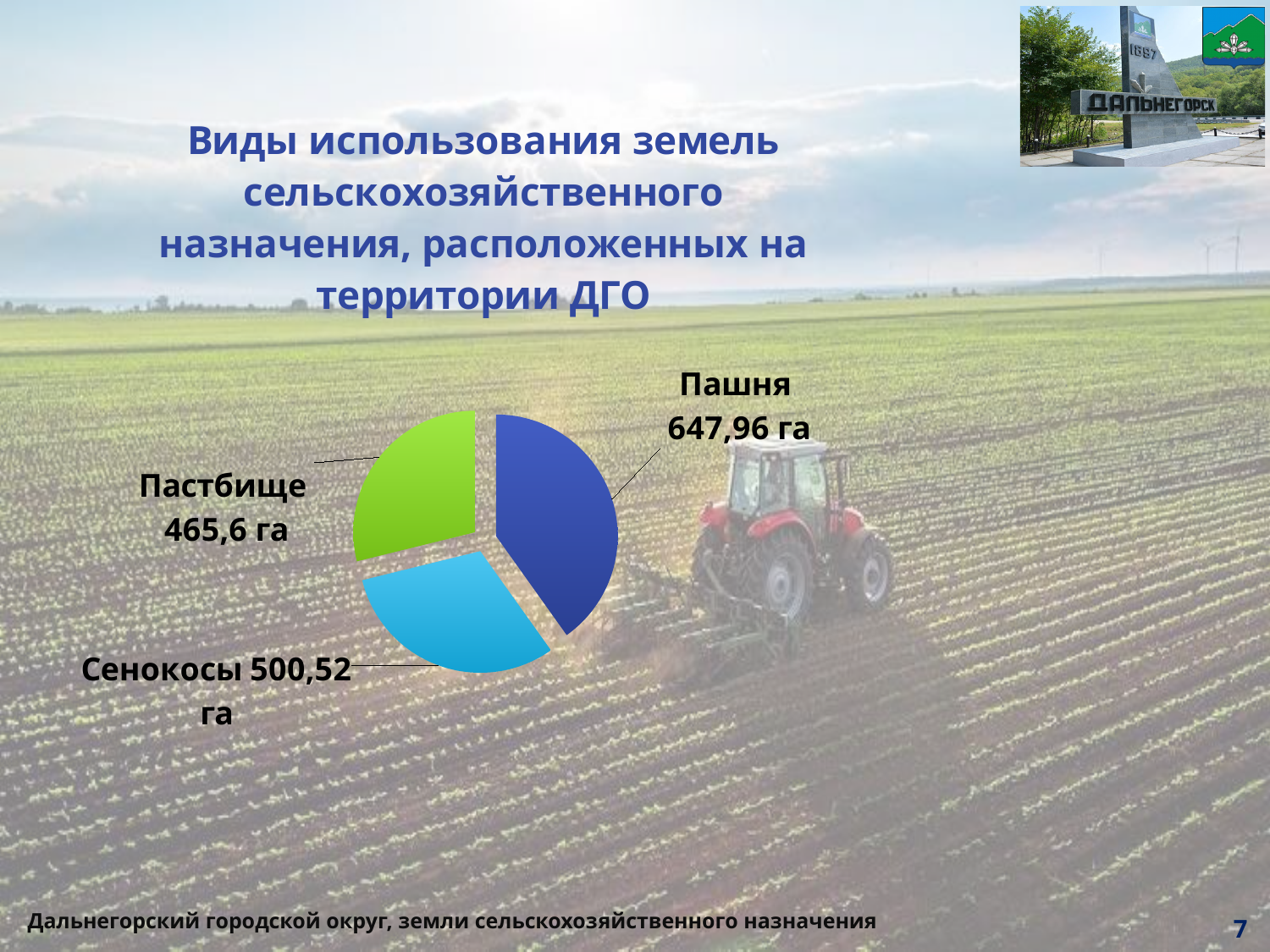
What is the total area of all three categories? 1614,08 га What colour is the Пастбище slice? Green What is the value for Пастбище? 465,6 га Which category has the smallest area? Пастбище Which is larger, Сенокосы or Пастбище? Сенокосы Which category has the largest area? Пашня What is the value for Пашня? 647,96 га How many categories does the pie chart show? 3 What type of chart is shown on the slide? Pie chart What is the difference between Пашня and Пастбище? 182,36 га What is the difference between Пашня and Сенокосы? 147,44 га What is the value for Сенокосы? 500,52 га